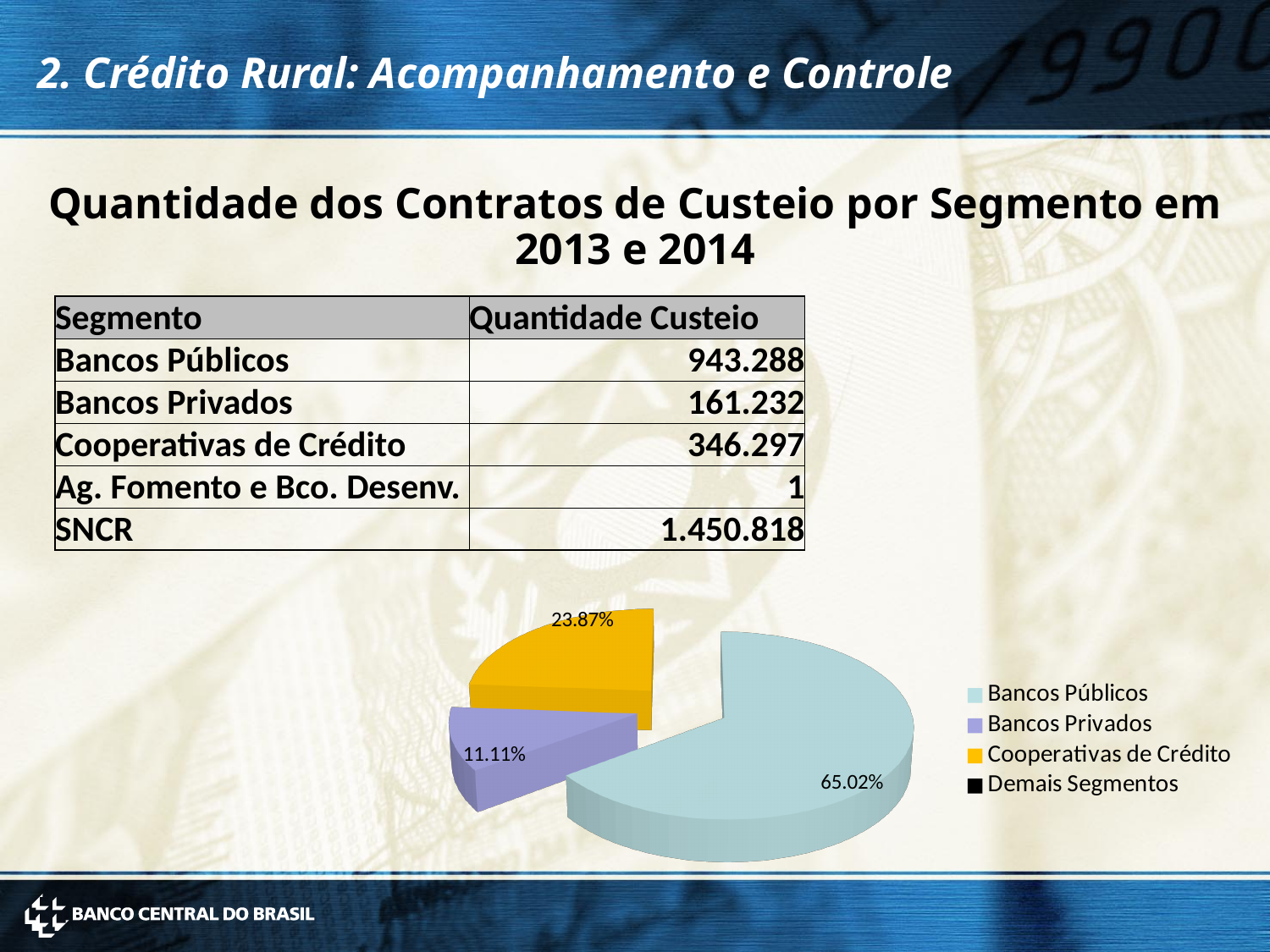
What is the difference in percentage points between the Cooperativas de Crédito slice and the Bancos Privados slice? 12.76 Which slice is larger in the pie chart, Bancos Privados or Cooperativas de Crédito? Cooperativas de Crédito In the pie chart, what share is shown for Bancos Públicos? 65.02% What is the difference in percentage points between the Bancos Públicos slice and the Cooperativas de Crédito slice? 41.15 In the pie chart, what share is shown for Cooperativas de Crédito? 23.87% Which of the labelled slices in the pie chart is the smallest? Bancos Privados Which legend entry in the pie chart is shown in black? Demais Segmentos Which segment has the largest slice in the pie chart? Bancos Públicos How many entries does the pie chart's legend list? 4 In the pie chart, what share is shown for Bancos Privados? 11.11% What colour is the Cooperativas de Crédito slice in the pie chart? yellow What kind of chart is shown on the slide? pie chart